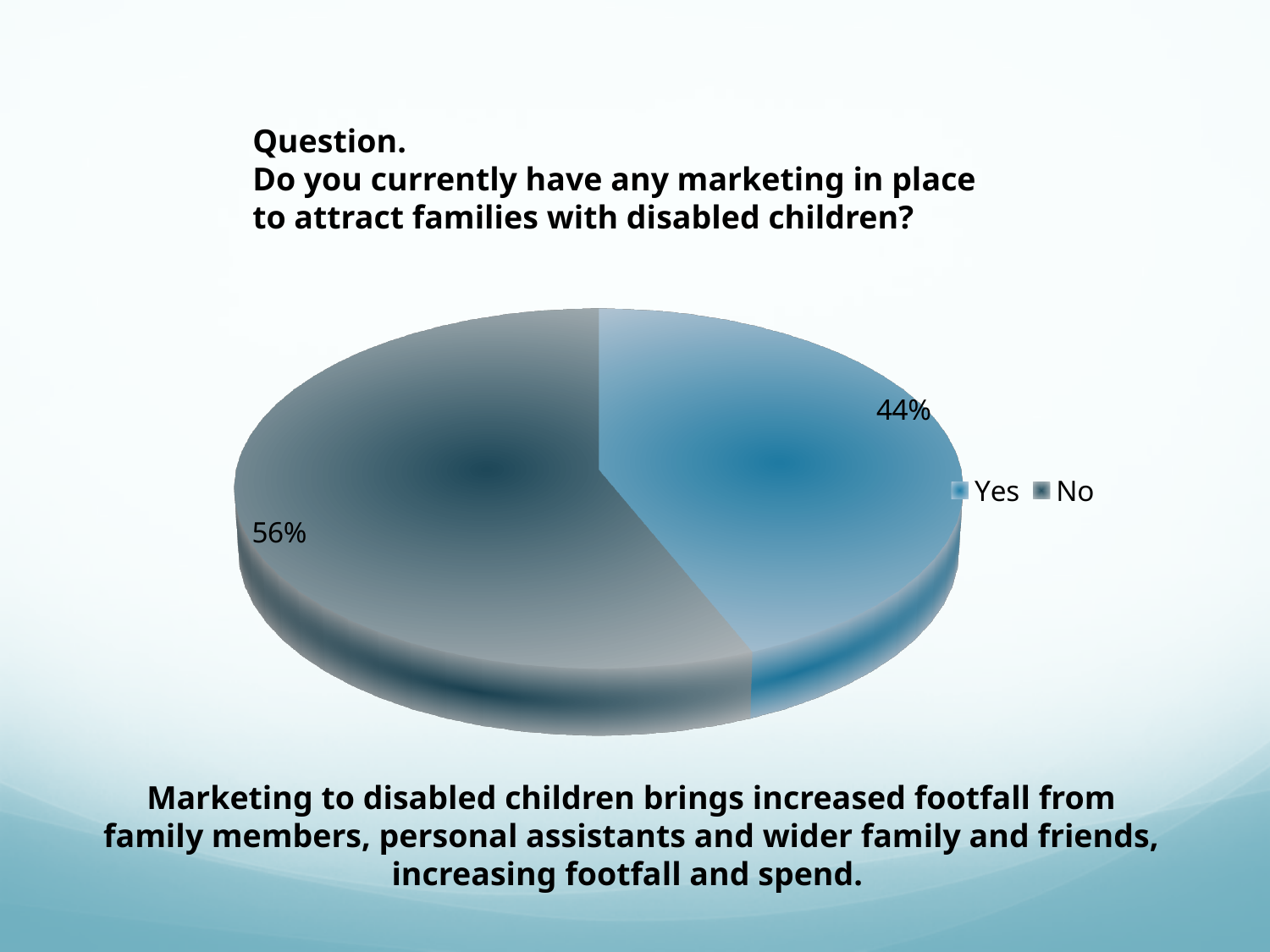
What percentage of respondents answered No? 56% How many entries does the legend list? 2 Which response has the larger share of the pie? No Is the value for No greater or less than 50%? greater Which response has the smaller share of the pie? Yes How many slices does the pie chart have? 2 What percentage of respondents answered Yes? 44% What kind of chart is shown on the slide? pie chart What is the difference in percentage points between the No and Yes slices? 12 Which legend entry is shown in blue? Yes What share of the pie does the Yes slice represent? 44% Is the share for Yes larger or smaller than the share for No? smaller